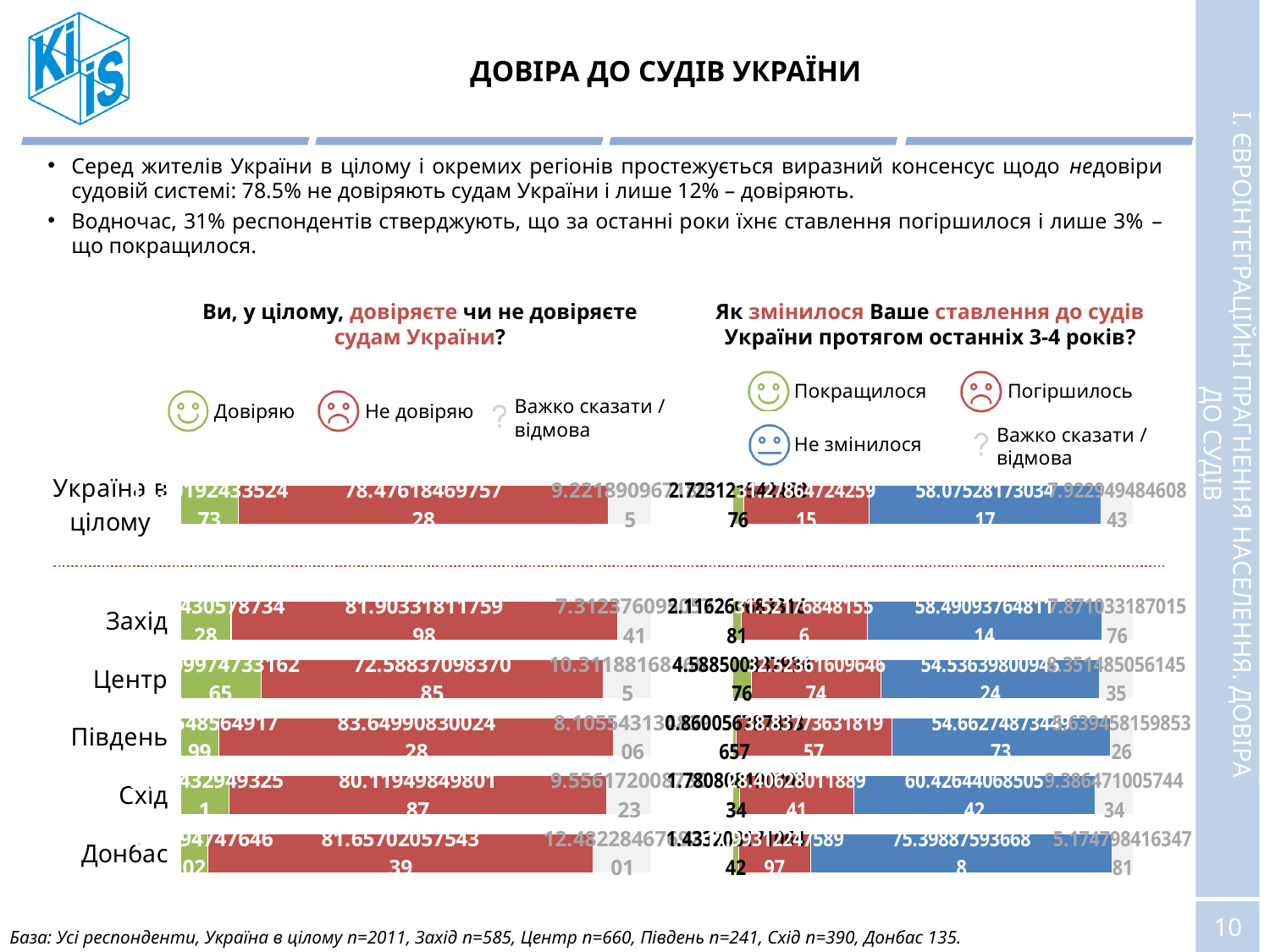
In the left chart, which region has the smallest "Довіряю" segment? Донбас In the left chart, which region has the largest "Довіряю" segment? Центр What colour represents the "Не змінилося" series in the right chart? Blue In the right chart, which region has the largest "Не змінилося" segment? Донбас How many regional categories (rows) are plotted in the left chart? 6 In the right chart, which region has the smallest "Погіршилось" segment? Донбас What kind of chart is used on the left, titled "Ви, у цілому, довіряєте чи не довіряєте судам України?"? Bar chart How many series does the legend of the right chart ("Як змінилося Ваше ставлення до судів України протягом останніх 3-4 років?") list? 4 In the left chart, for "Україна в цілому", which is larger: "Довіряю" or "Не довіряю"? Не довіряю What is the title of the slide? ДОВІРА ДО СУДІВ УКРАЇНИ In the right chart, for "Україна в цілому", which is larger: "Покращилося" or "Погіршилось"? Погіршилось How many series does the legend of the left chart ("Ви, у цілому, довіряєте чи не довіряєте судам України?") list? 3